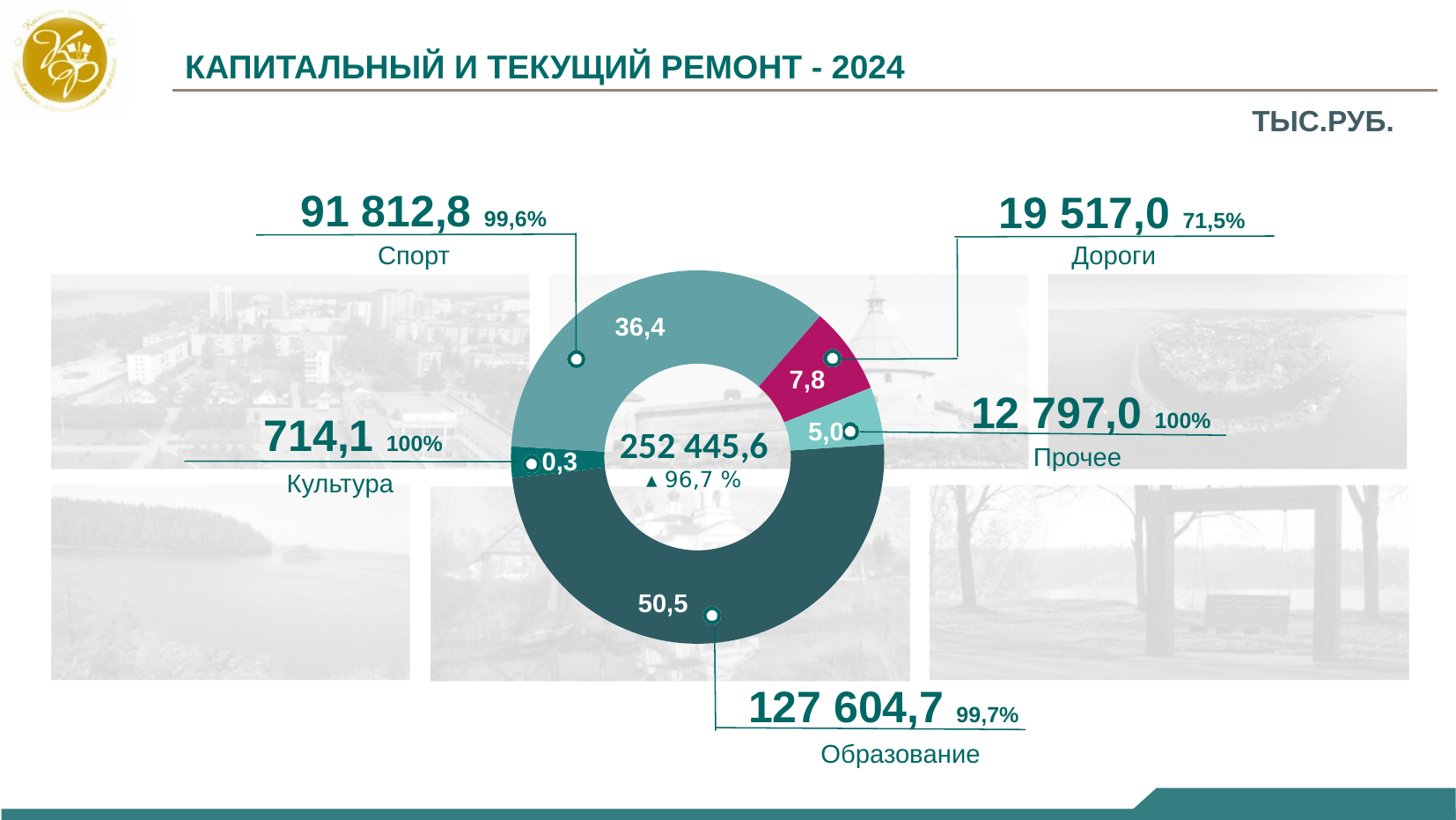
What share of the donut does Образование take? 50,5 Which is larger, the value for Дороги or the value for Прочее? Дороги What is the value for Дороги in thousand rubles? 19 517,0 Which category has the largest value? Образование What kind of chart is shown on the slide? Pie (donut) chart What execution percentage is shown next to Дороги? 71,5% What is the value for Образование in thousand rubles? 127 604,7 What total value is shown in the centre of the donut chart? 252 445,6 How many categories does the donut chart show? 5 What is the value for Спорт in thousand rubles? 91 812,8 What share of the donut does Прочее take? 5,0 Which category has the smallest value? Культура